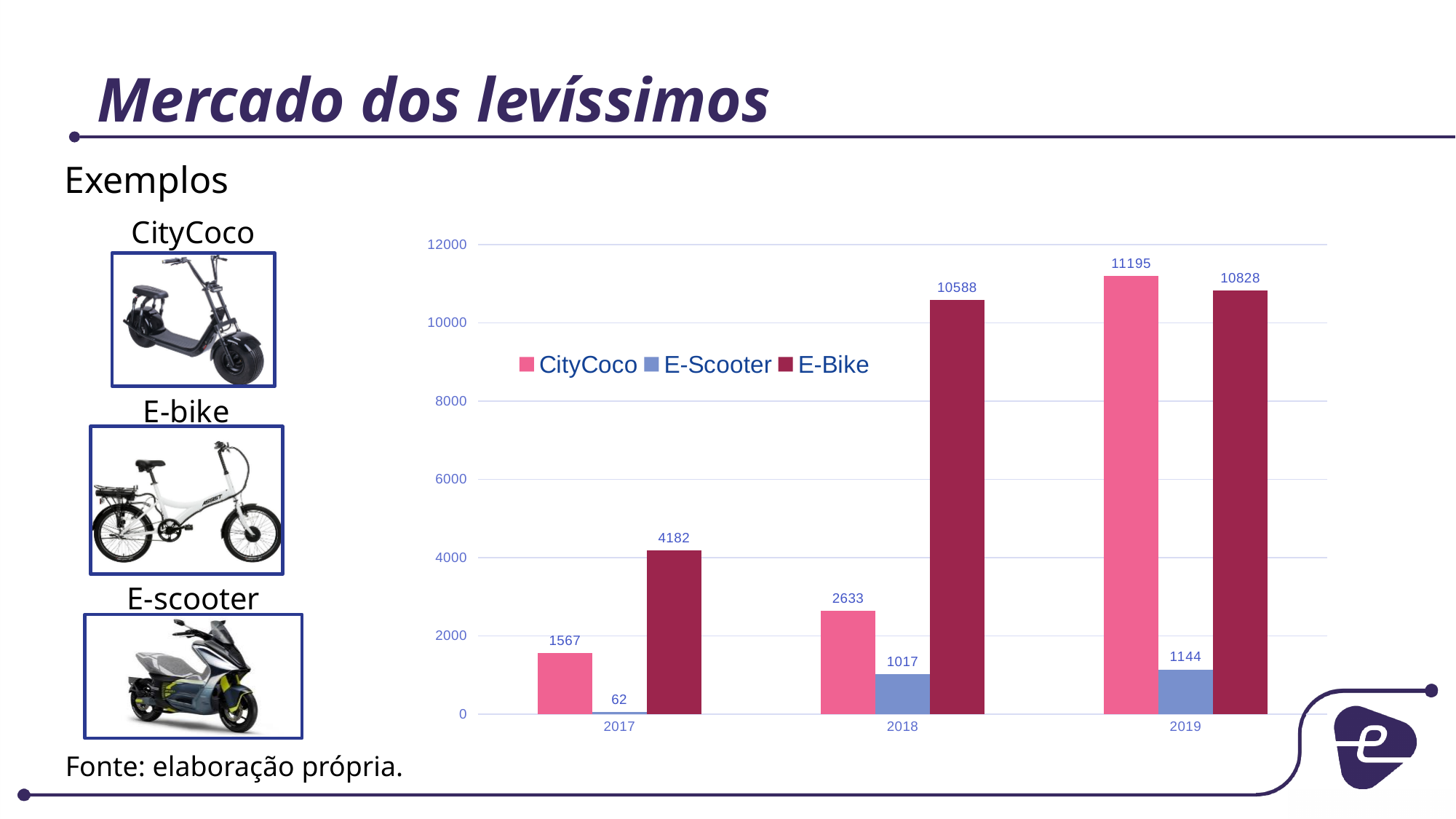
Which series has the highest value in 2017? E-Bike How many series does the legend list? 3 In 2019, which is larger: the CityCoco value or the E-Bike value? CityCoco Do the CityCoco values rise or fall from 2017 to 2019? rise What is the difference between the E-Bike value in 2018 and the E-Bike value in 2017? 6406 Is the value for CityCoco in 2018 greater or less than 2000? greater What is the value for CityCoco in 2019? 11195 What is the value for E-Bike in 2018? 10588 What kind of chart is shown on the slide? bar chart How many years are shown on the x axis? 3 What is the value for E-Scooter in 2017? 62 Which series has the lowest value in 2019? E-Scooter